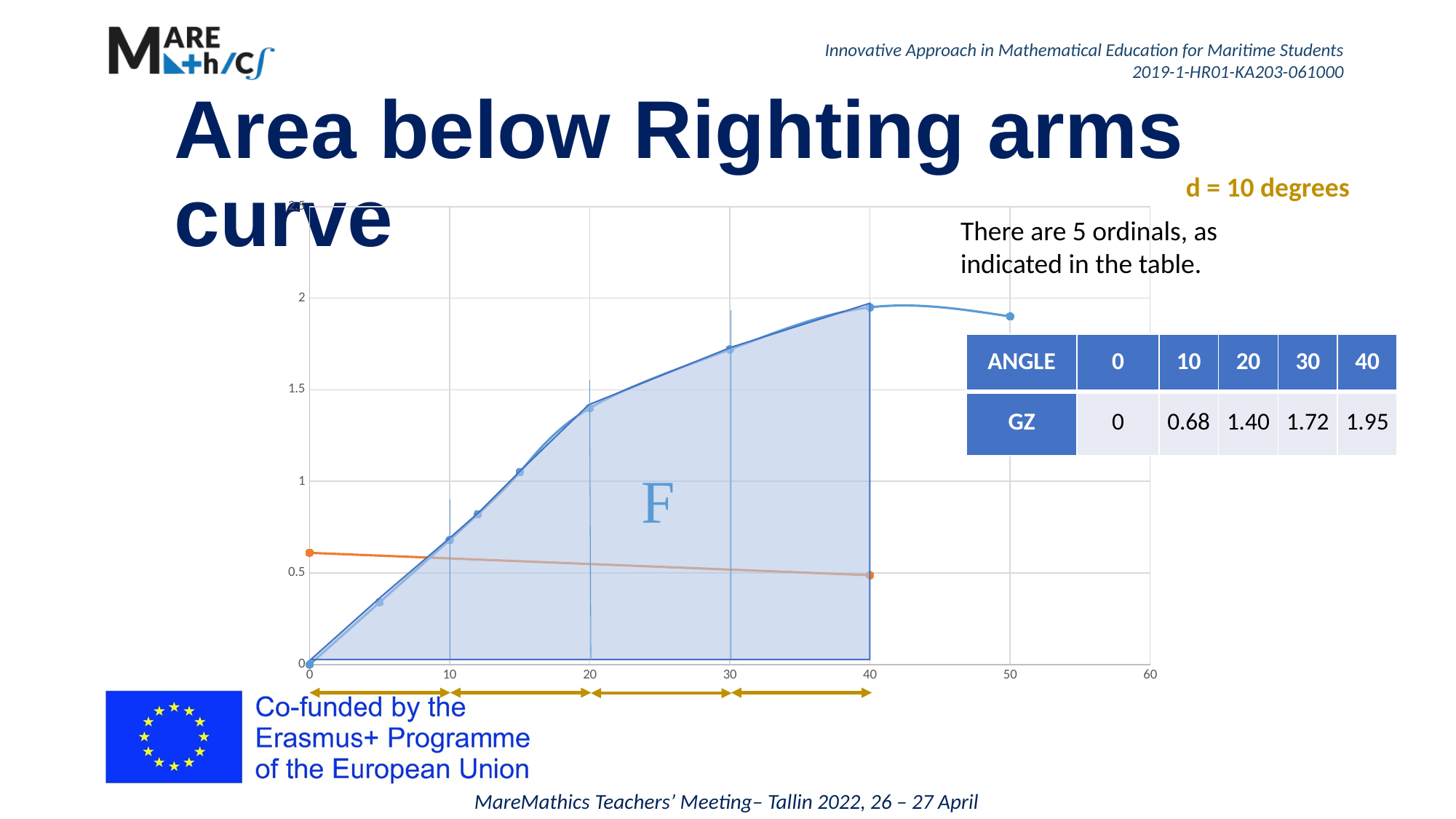
According to the table, what is the GZ value at an angle of 40? 1.95 Is the value of the blue curve at angle 50 greater or less than 1.5? greater What is the difference between the GZ values at angles 40 and 30 in the table? 0.23 According to the table, what is the GZ value at an angle of 10? 0.68 According to the table, what is the GZ value at an angle of 20? 1.40 Which angle has the larger GZ value in the table, 10 or 30? 30 What letter is printed inside the shaded area under the curve? F Does the blue righting arm curve rise or fall between angles 0 and 40? rise How many ordinals (angle values) are listed in the table? 5 Is the value of the orange line at angle 0 greater or less than 1? less What kind of chart is shown on the slide? line chart At which angle in the table is the GZ value highest? 40